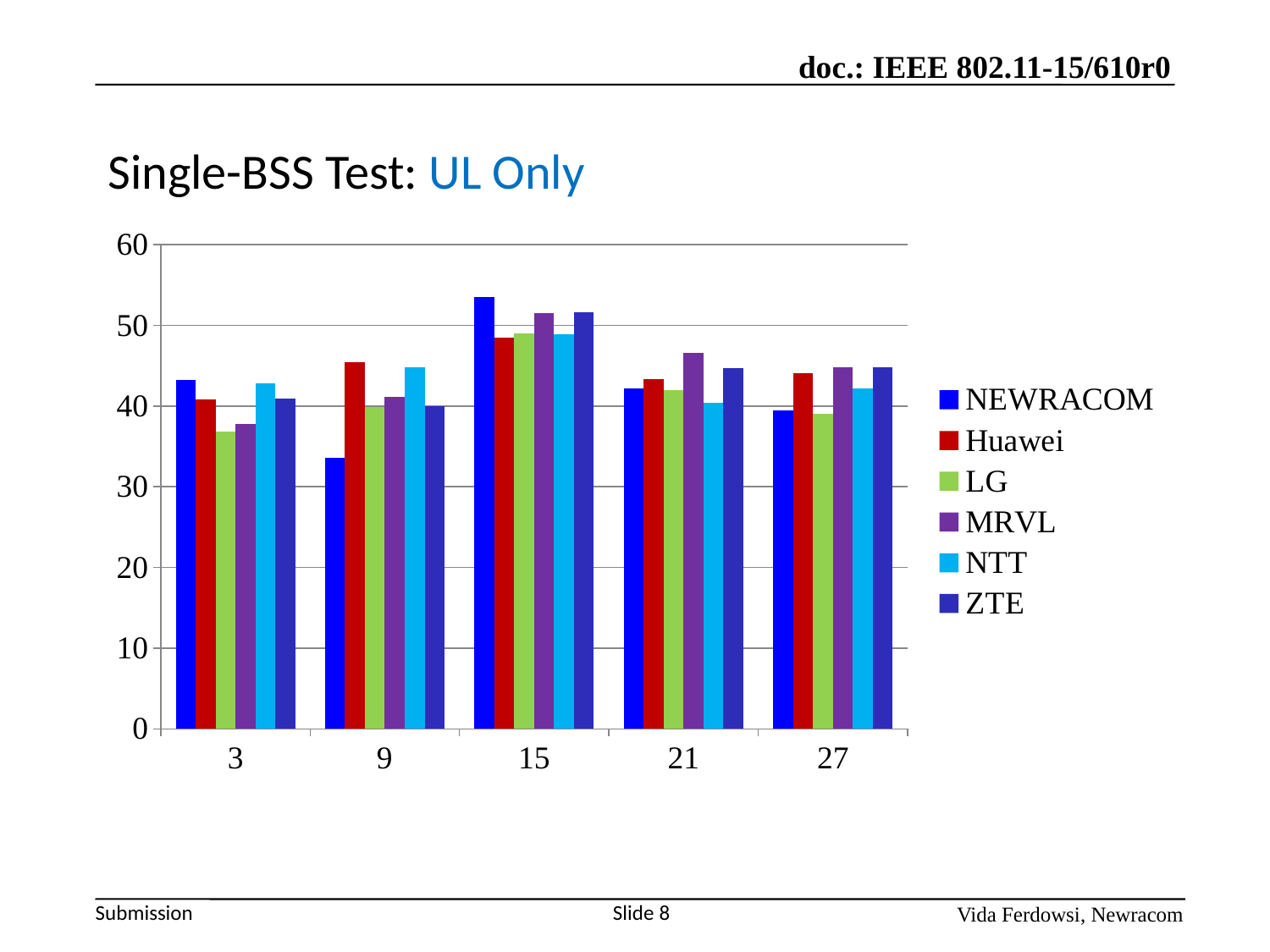
Is the value for NEWRACOM at category 15 greater or less than 50? greater What kind of chart is shown on the slide? bar chart Which series has the lowest value at category 9? NEWRACOM Does the NEWRACOM value rise or fall from category 9 to category 15? rise How many categories are shown on the x axis? 5 What is the title of the slide containing the chart? Single-BSS Test: UL Only Which series has the highest value at category 15? NEWRACOM Is the value for LG at category 3 greater or less than 40? less How many series does the legend list? 6 Which series has the highest value at category 21? MRVL At category 9, which is larger: Huawei or NEWRACOM? Huawei Is the value for NEWRACOM at category 9 greater or less than 40? less